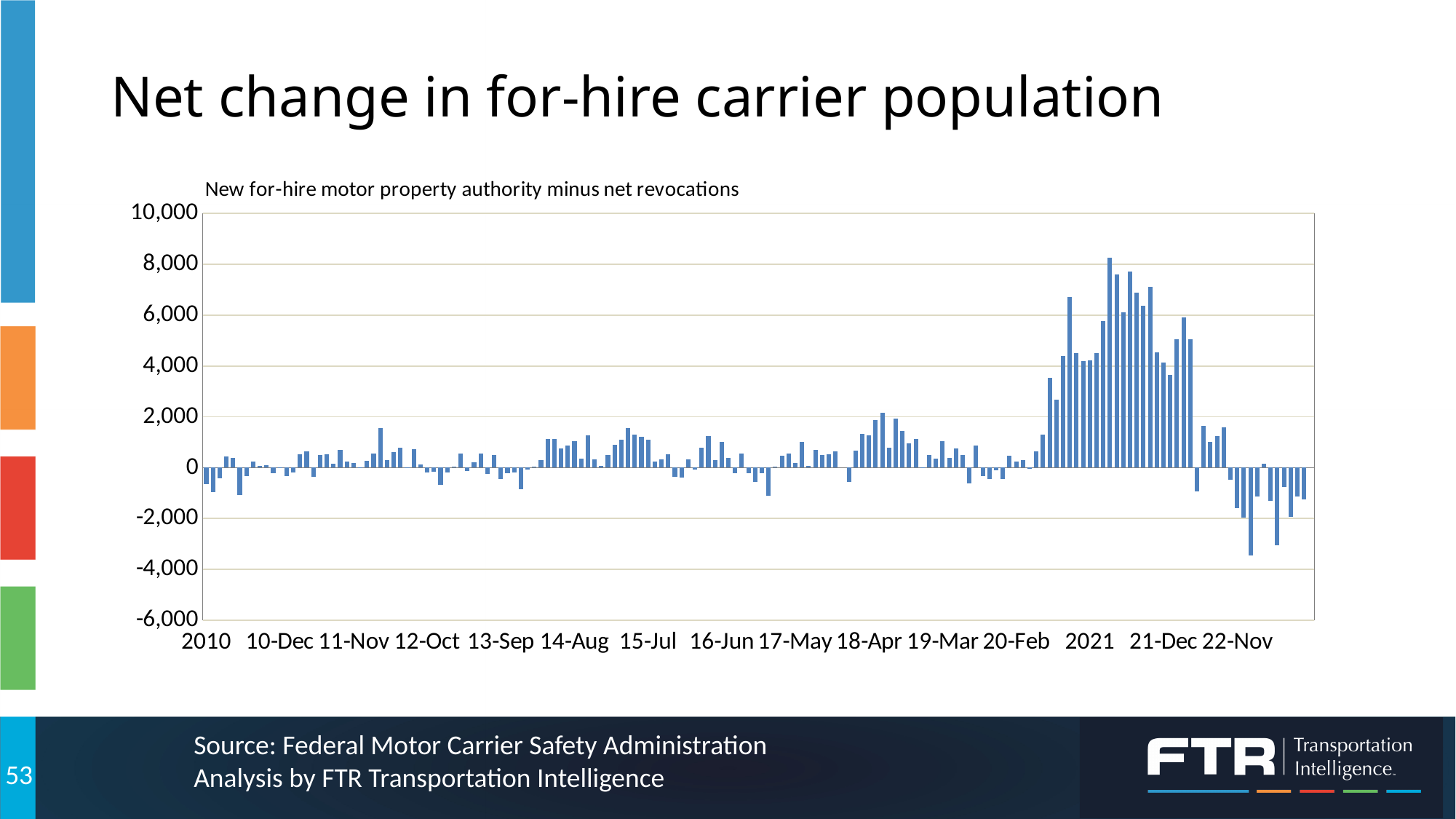
Is the highest bar on the chart greater or less than 4,000? greater Is the lowest bar on the chart greater or less than -2,000? less What is the title of the slide's chart? New for-hire motor property authority minus net revocations What subtitle appears above the chart's plot area? New for-hire motor property authority minus net revocations Between the 2021 label and the 22-Nov label, do the bar values generally rise or fall? fall What type of chart is shown on the slide? bar chart Between the 20-Feb label and the 2021 label, do the bar values generally rise or fall? rise Is the highest bar on the chart greater or less than 6,000? greater Which period has larger bar values: around the 2021 label or around the 2010 label? around 2021 Are the bars at the far right end of the chart, after the 22-Nov label, mostly positive or negative? negative How many labels are shown along the x axis of the chart? 15